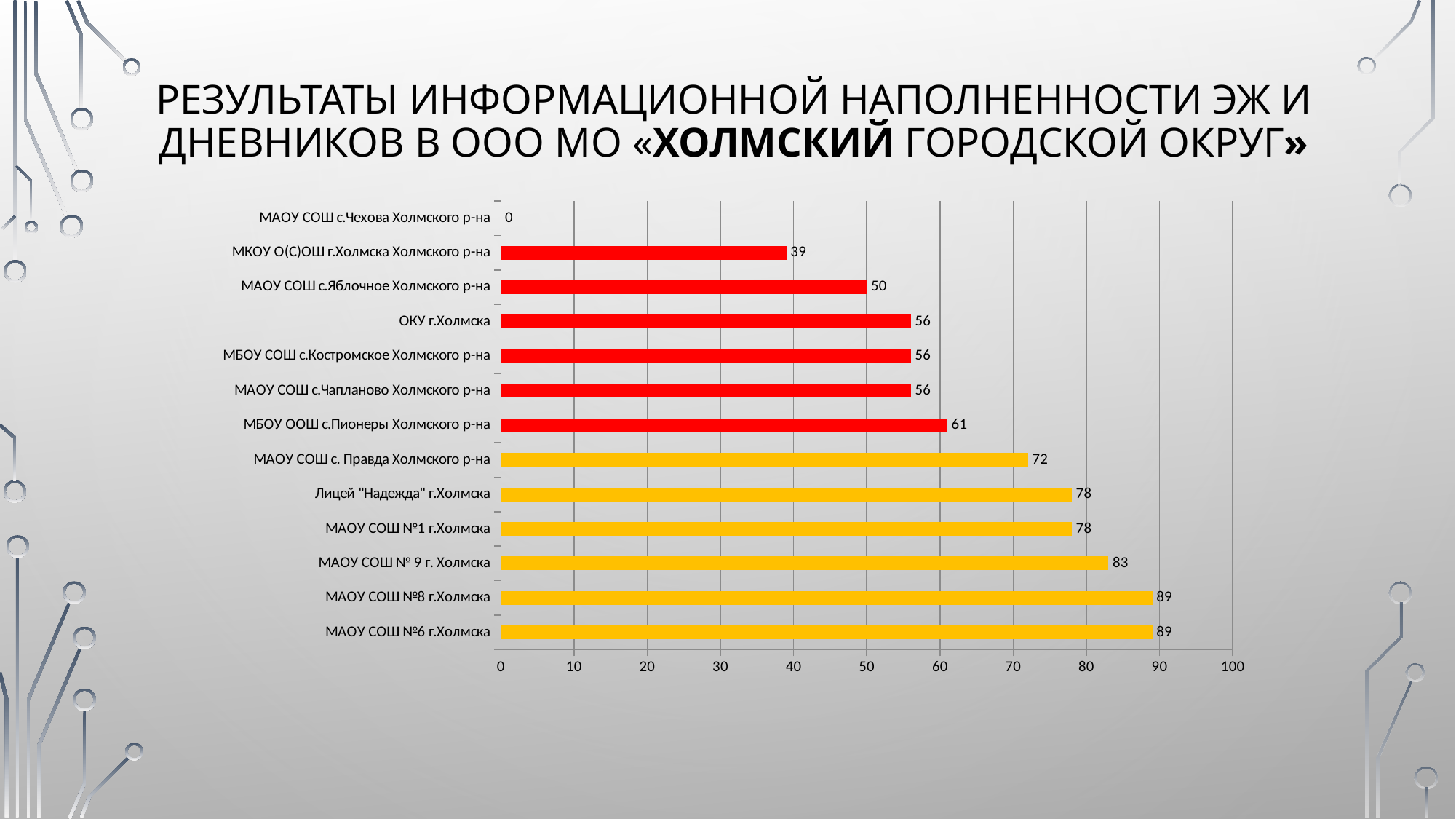
What kind of chart is shown on the slide? bar chart Which is larger: the value for Лицей "Надежда" г.Холмска or the value for ОКУ г.Холмска? Лицей "Надежда" г.Холмска What is the value for МАОУ СОШ с. Правда Холмского р-на? 72 What is the maximum value shown on the horizontal axis? 100 What colour are the bars for the categories with values of 72 and above? yellow What is the difference between the values for МАОУ СОШ №8 г.Холмска and МАОУ СОШ с.Яблочное Холмского р-на? 39 What is the value for МАОУ СОШ № 9 г. Холмска? 83 Which category has the lowest value? МАОУ СОШ с.Чехова Холмского р-на How many categories are shown on the chart? 13 What is the value for МКОУ О(С)ОШ г.Холмска Холмского р-на? 39 What is the highest value shown on the chart? 89 What is the value for МБОУ ООШ с.Пионеры Холмского р-на? 61